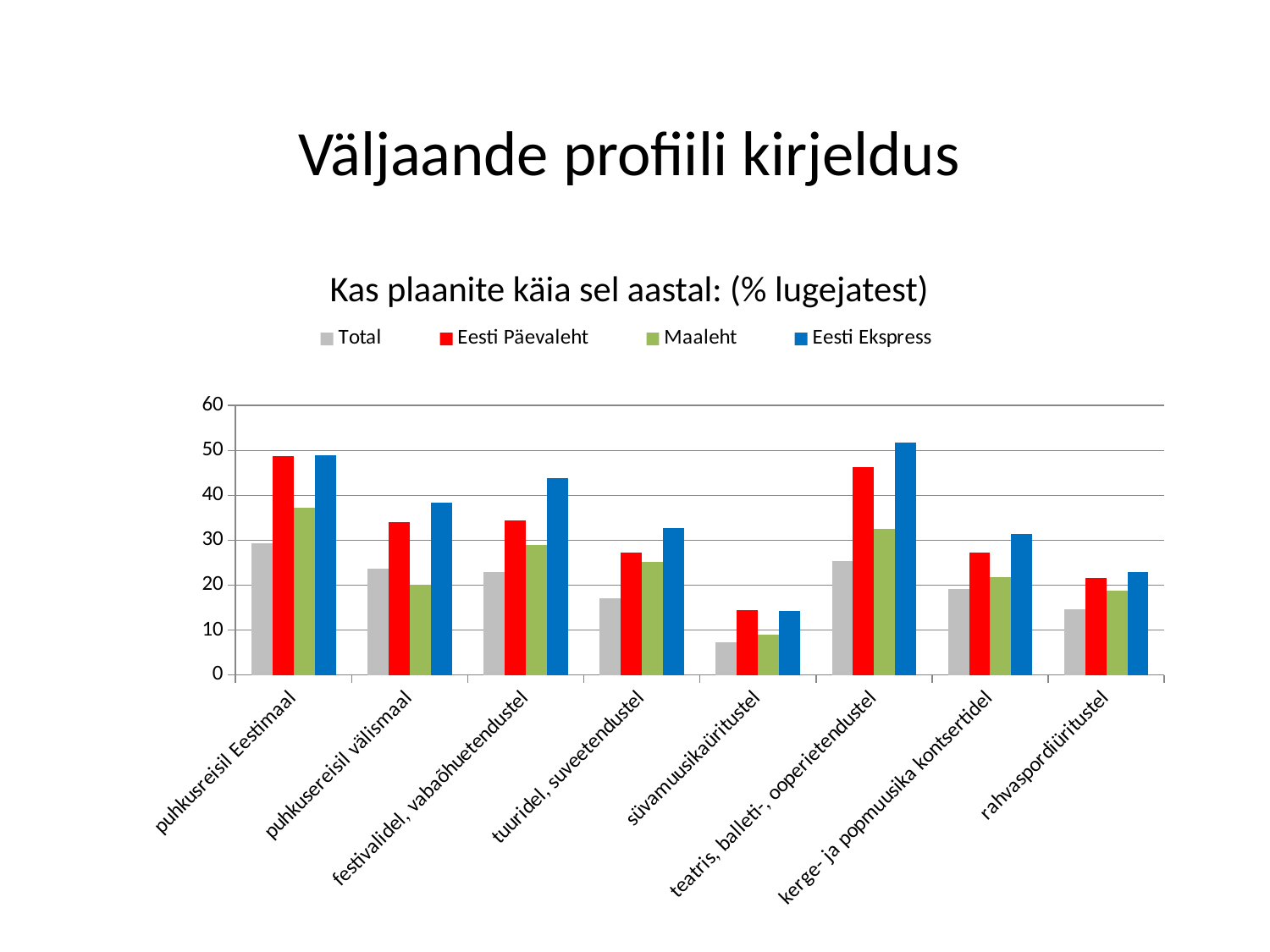
Is the Eesti Ekspress value for teatris, balleti-, ooperietendustel greater or less than 50? greater What kind of chart is shown on the slide? bar chart How many series does the legend list? 4 For which category is the Total value lowest? süvamuusikaüritustel For festivalidel, vabaõhuetendustel, which is larger: the Eesti Ekspress value or the Maaleht value? Eesti Ekspress How many categories are shown on the x axis? 8 Is the Eesti Päevaleht value for teatris, balleti-, ooperietendustel greater or less than 40? greater For which category is the Eesti Ekspress value highest? teatris, balleti-, ooperietendustel For süvamuusikaüritustel, which is larger: the Total value or the Eesti Päevaleht value? Eesti Päevaleht What colour represents the Eesti Ekspress series in the legend? blue What is the title of the chart? Kas plaanite käia sel aastal: (% lugejatest) Is the Total value for süvamuusikaüritustel greater or less than 10? less